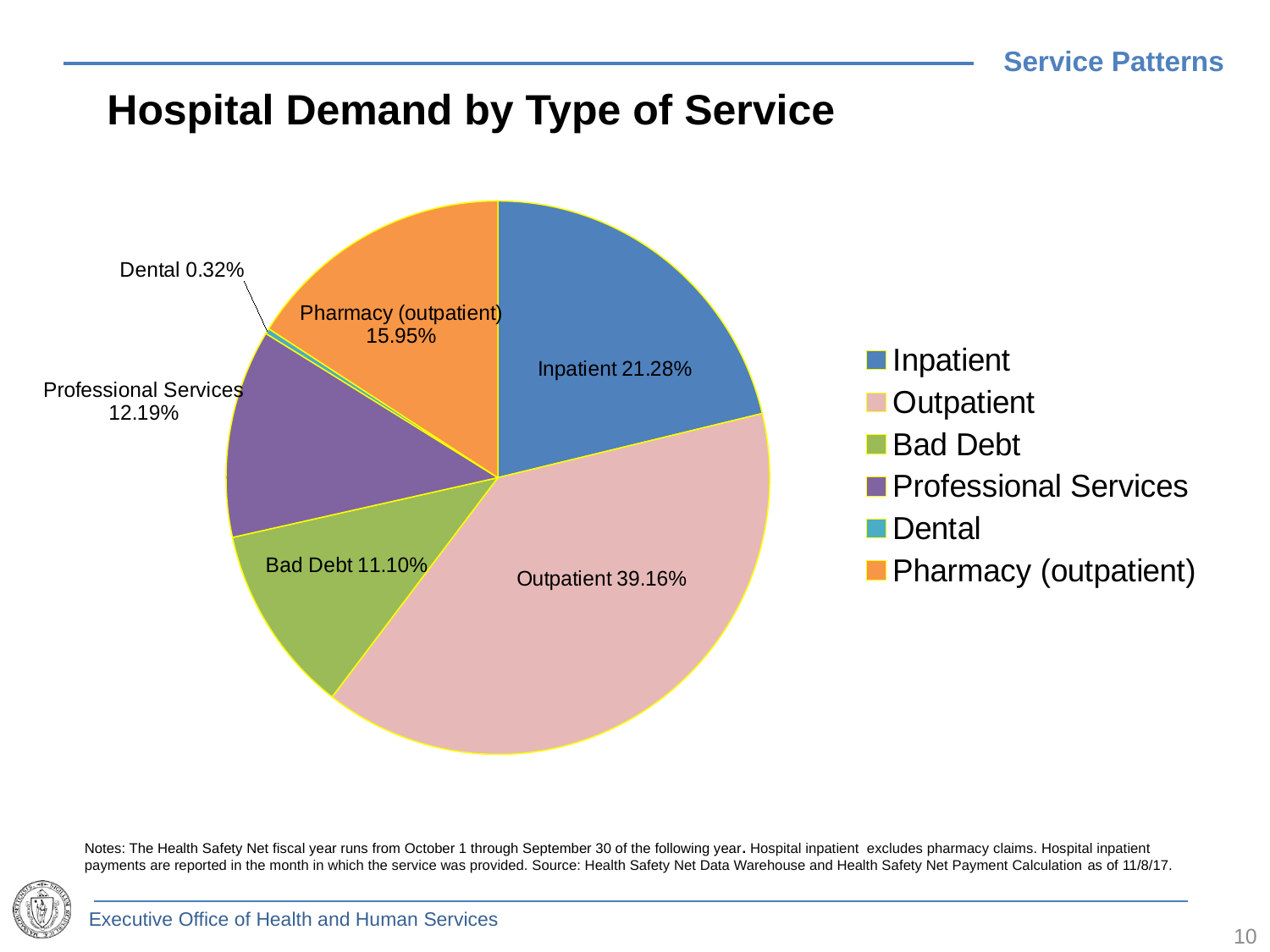
What share of hospital demand is Professional Services? 12.19% What type of chart is shown on the slide? pie chart How many slices does the pie chart have? 6 What is the title of the chart? Hospital Demand by Type of Service Which type of service has the smallest share of hospital demand? Dental Which type of service has the largest share of hospital demand? Outpatient What is the difference in percentage points between the Outpatient and Inpatient shares? 17.88 What share of hospital demand is Pharmacy (outpatient)? 15.95% Which has a larger share, Bad Debt or Professional Services? Professional Services What share of hospital demand is Outpatient? 39.16% What share of hospital demand is Inpatient? 21.28% What share of hospital demand is Dental? 0.32%